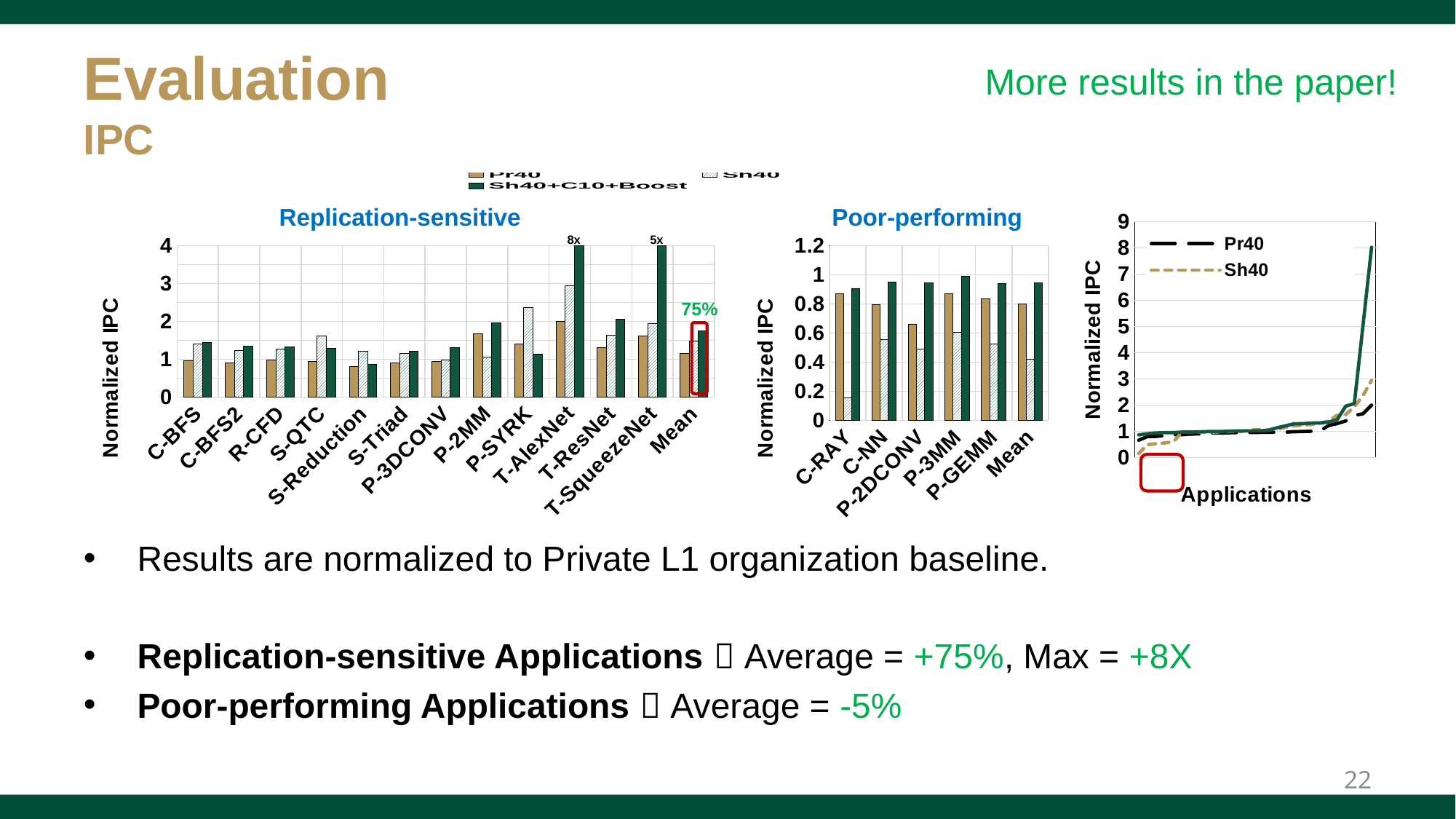
How many categories (including Mean) are shown on the x axis of the Poor-performing chart? 6 In the Poor-performing chart, which is larger for C-NN, the Pr40 value or the Sh40 value? Pr40 In the Replication-sensitive chart, is the Sh40 value for P-SYRK greater or less than 2? greater How many application categories (including Mean) are shown on the x axis of the Replication-sensitive chart? 13 In the Replication-sensitive chart, what value is labelled above the Sh40+C10+Boost bar for T-SqueezeNet? 5x In the Replication-sensitive chart, is the Pr40 value for S-Reduction greater or less than 1? less In the Poor-performing chart, which application has the lowest Sh40 value? C-RAY In the Replication-sensitive chart, which application has the highest Sh40+C10+Boost value? T-AlexNet What kind of chart is the rightmost chart with the x-axis labelled Applications? line chart In the Replication-sensitive chart, what value is labelled above the Sh40+C10+Boost bar for T-AlexNet? 8x What kind of chart is the Replication-sensitive chart? bar chart How many series does the legend of the rightmost line chart list? 2